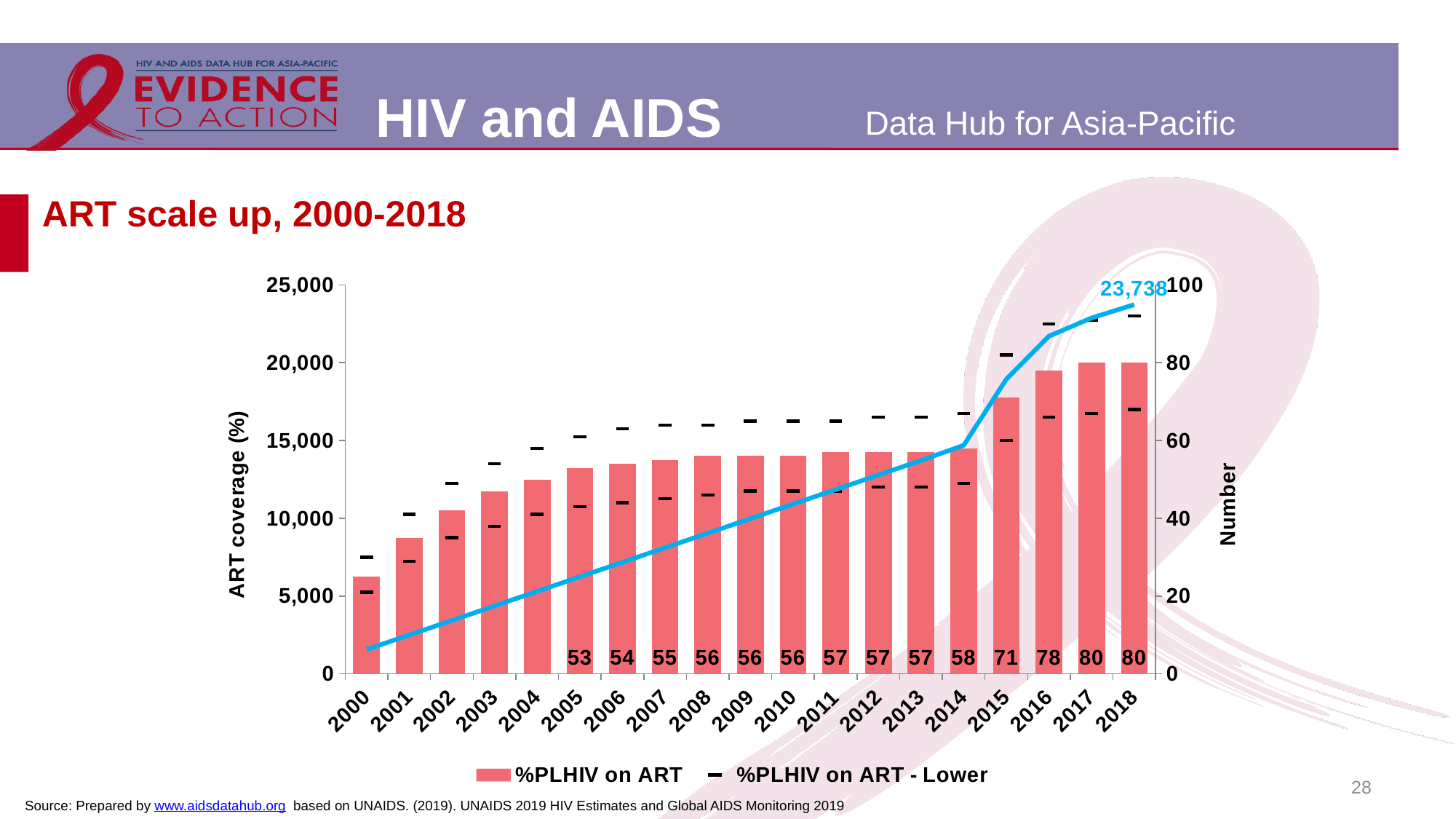
What is the %PLHIV on ART value shown for 2015? 71 What value is labelled at the end of the blue line in 2018? 23,738 By how many points did %PLHIV on ART increase from 2005 to 2018? 27 What is the %PLHIV on ART value shown for 2018? 80 Is the bar for 2000 greater or less than 10,000 on the left-hand axis? less How many series does the legend list? 2 Do the %PLHIV on ART bars generally rise or fall from 2000 to 2018? rise How many years are shown on the x axis? 19 What is the %PLHIV on ART value shown for 2005? 53 Which year has the lowest %PLHIV on ART bar? 2000 What is the difference between the %PLHIV on ART values for 2015 and 2014? 13 Which year has the higher %PLHIV on ART value, 2010 or 2016? 2016